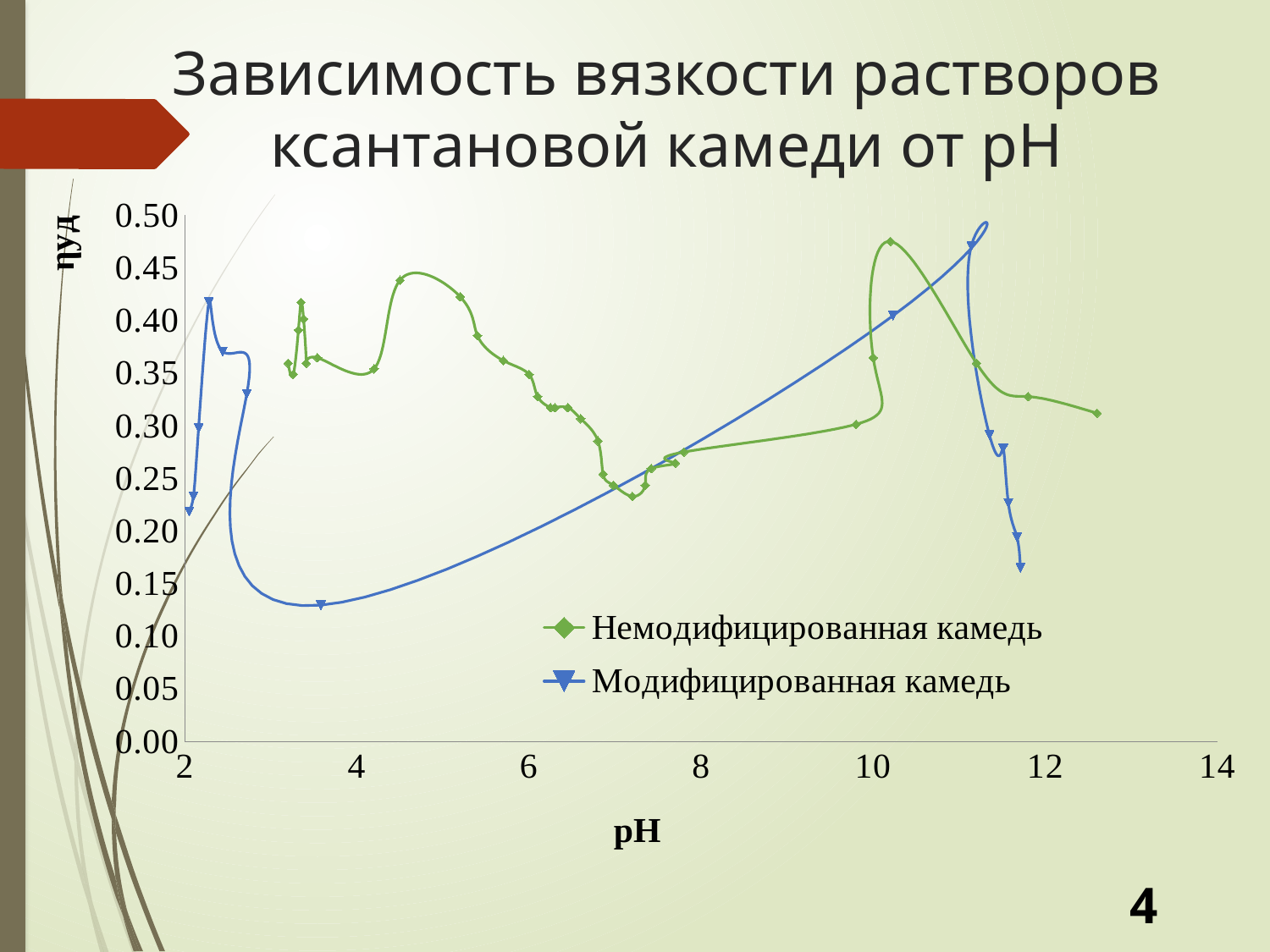
Is the lowest value of the Модифицированная камедь series (near pH 3.6) greater or less than 0.15? less At pH 4, which series has the higher viscosity: Немодифицированная камедь or Модифицированная камедь? Немодифицированная камедь What kind of chart is shown on the slide? line chart Does the Немодифицированная камедь series rise or fall between pH 10.2 and pH 12.6? fall What quantity is plotted on the x axis? pH How many series does the legend list? 2 Is the last point of the Модифицированная камедь series (near pH 11.7) greater or less than 0.20? less Is the peak value of the Немодифицированная камедь series near pH 10 greater or less than 0.45? greater What is the title of the chart? Зависимость вязкости растворов ксантановой камеди от pH Does the Модифицированная камедь series rise or fall between pH 11.2 and pH 11.7? fall